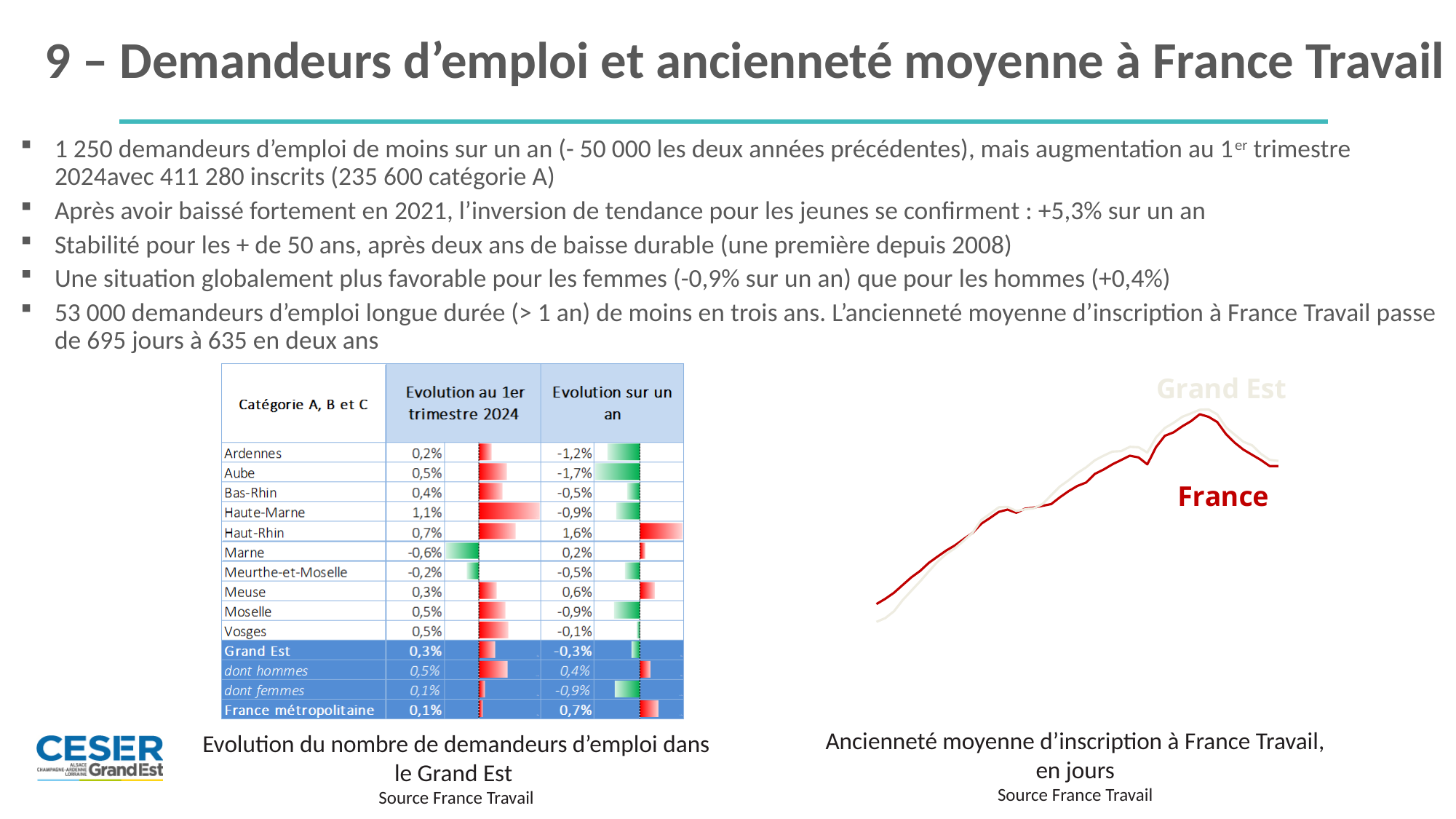
In the table 'Evolution du nombre de demandeurs d'emploi dans le Grand Est', which department has the lowest 'Evolution sur un an'? Aube In the table 'Evolution du nombre de demandeurs d'emploi dans le Grand Est', which department has the highest 'Evolution au 1er trimestre 2024'? Haute-Marne In the table 'Evolution du nombre de demandeurs d'emploi dans le Grand Est', which has the larger 'Evolution au 1er trimestre 2024', Moselle or Meuse? Moselle In the table 'Evolution du nombre de demandeurs d'emploi dans le Grand Est', which department has the lowest 'Evolution au 1er trimestre 2024'? Marne In the table 'Evolution du nombre de demandeurs d'emploi dans le Grand Est', what is the 'Evolution sur un an' value for Aube? -1,7% In the table 'Evolution du nombre de demandeurs d'emploi dans le Grand Est', how many departments are listed (excluding the Grand Est and France métropolitaine rows)? 10 In the table 'Evolution du nombre de demandeurs d'emploi dans le Grand Est', what is the 'Evolution au 1er trimestre 2024' value for Haute-Marne? 1,1% What kind of chart is 'Ancienneté moyenne d'inscription à France Travail, en jours' on the right of the slide? Line chart In the table 'Evolution du nombre de demandeurs d'emploi dans le Grand Est', what is the 'Evolution sur un an' value for 'dont femmes'? -0,9% In the table 'Evolution du nombre de demandeurs d'emploi dans le Grand Est', which department has the highest 'Evolution sur un an'? Haut-Rhin How many series are shown in the chart 'Ancienneté moyenne d'inscription à France Travail, en jours'? 2 In the table 'Evolution du nombre de demandeurs d'emploi dans le Grand Est', what is the difference in percentage points between the 'Evolution sur un an' of Haut-Rhin and Aube? 3,3 points